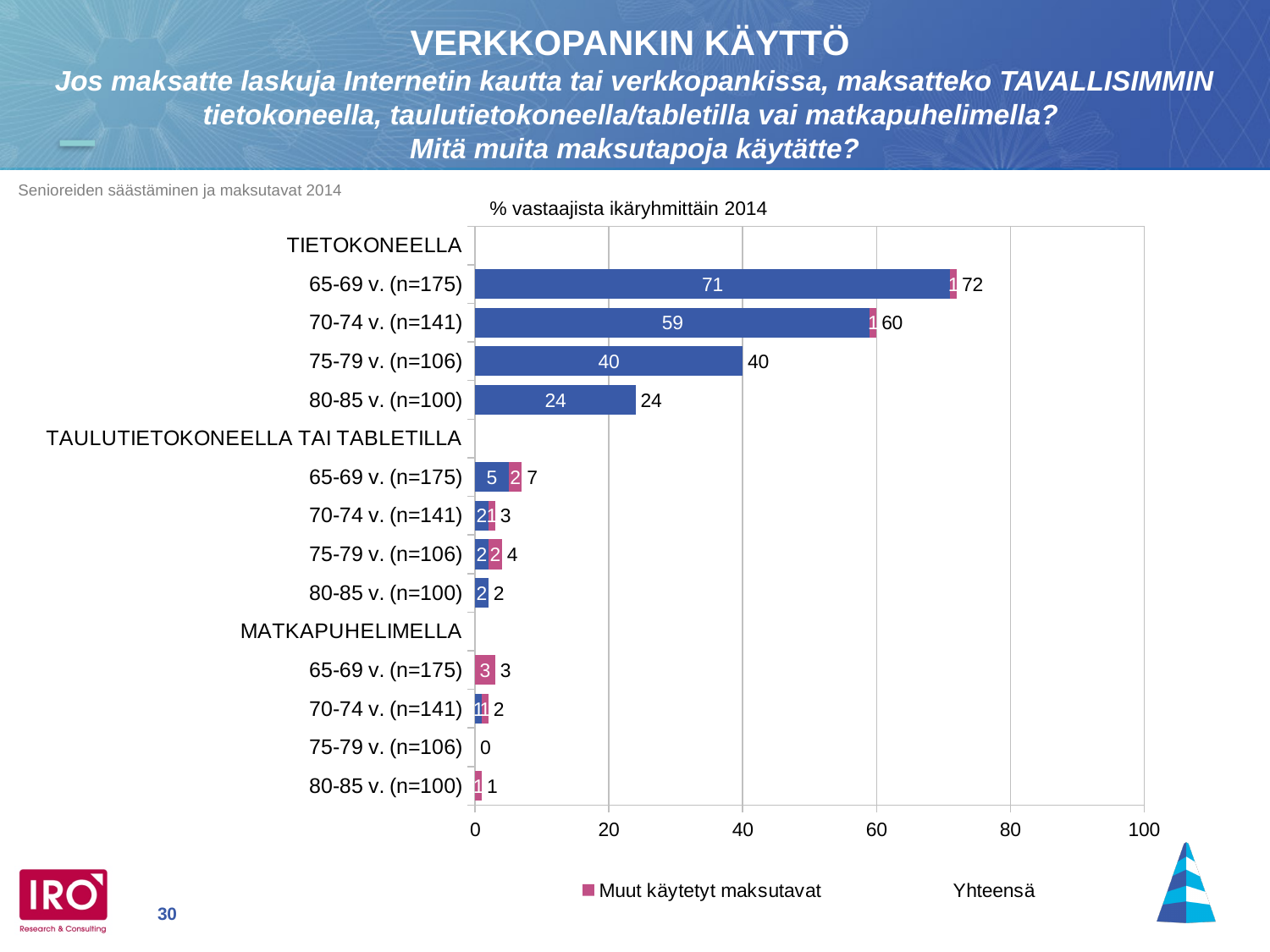
What is the total (Yhteensä) value for 65-69 v. (n=175) under TIETOKONEELLA? 72 What is the value of the Muut käytetyt maksutavat segment for 75-79 v. (n=106) under TAULUTIETOKONEELLA TAI TABLETILLA? 2 What is the total (Yhteensä) value for 70-74 v. (n=141) under TIETOKONEELLA? 60 What is the total value for 80-85 v. (n=100) under TIETOKONEELLA? 24 Which age group has the highest total under TIETOKONEELLA? 65-69 v. (n=175) What is the title shown above the chart? % vastaajista ikäryhmittäin 2014 Do the TIETOKONEELLA totals rise or fall as the age group gets older? fall What is the total value for 65-69 v. (n=175) under TAULUTIETOKONEELLA TAI TABLETILLA? 7 Which is larger: the TIETOKONEELLA total for 70-74 v. (n=141) or for 75-79 v. (n=106)? 70-74 v. (n=141) What is the total value for 75-79 v. (n=106) under MATKAPUHELIMELLA? 0 What kind of chart is shown on the slide? bar chart What is the difference between the TIETOKONEELLA totals for 65-69 v. (n=175) and 80-85 v. (n=100)? 48